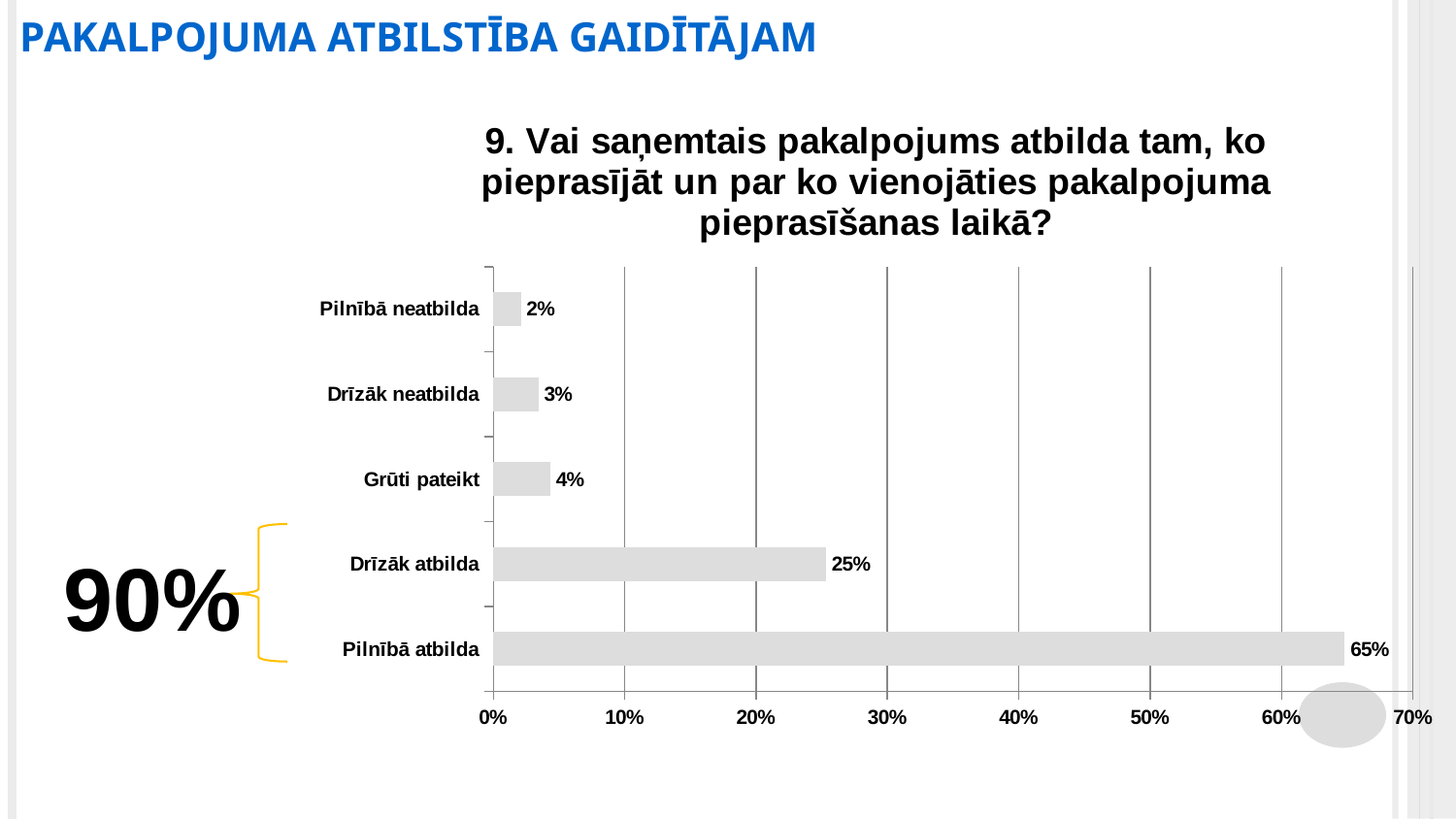
What kind of chart is shown on the slide? bar chart What is the value for "Drīzāk atbilda"? 25% Is the value for "Pilnībā atbilda" greater or less than 60%? greater What is the combined value of "Pilnībā atbilda" and "Drīzāk atbilda" as highlighted by the bracket on the left? 90% What is the value for "Grūti pateikt"? 4% Which is larger, the value for "Drīzāk neatbilda" or the value for "Grūti pateikt"? Grūti pateikt How many categories are shown in the chart? 5 Which category has the lowest value? Pilnībā neatbilda What is the value for "Pilnībā atbilda"? 65% What is the difference between the values for "Pilnībā atbilda" and "Drīzāk atbilda"? 40% What is the value for "Pilnībā neatbilda"? 2% Which category has the highest value? Pilnībā atbilda